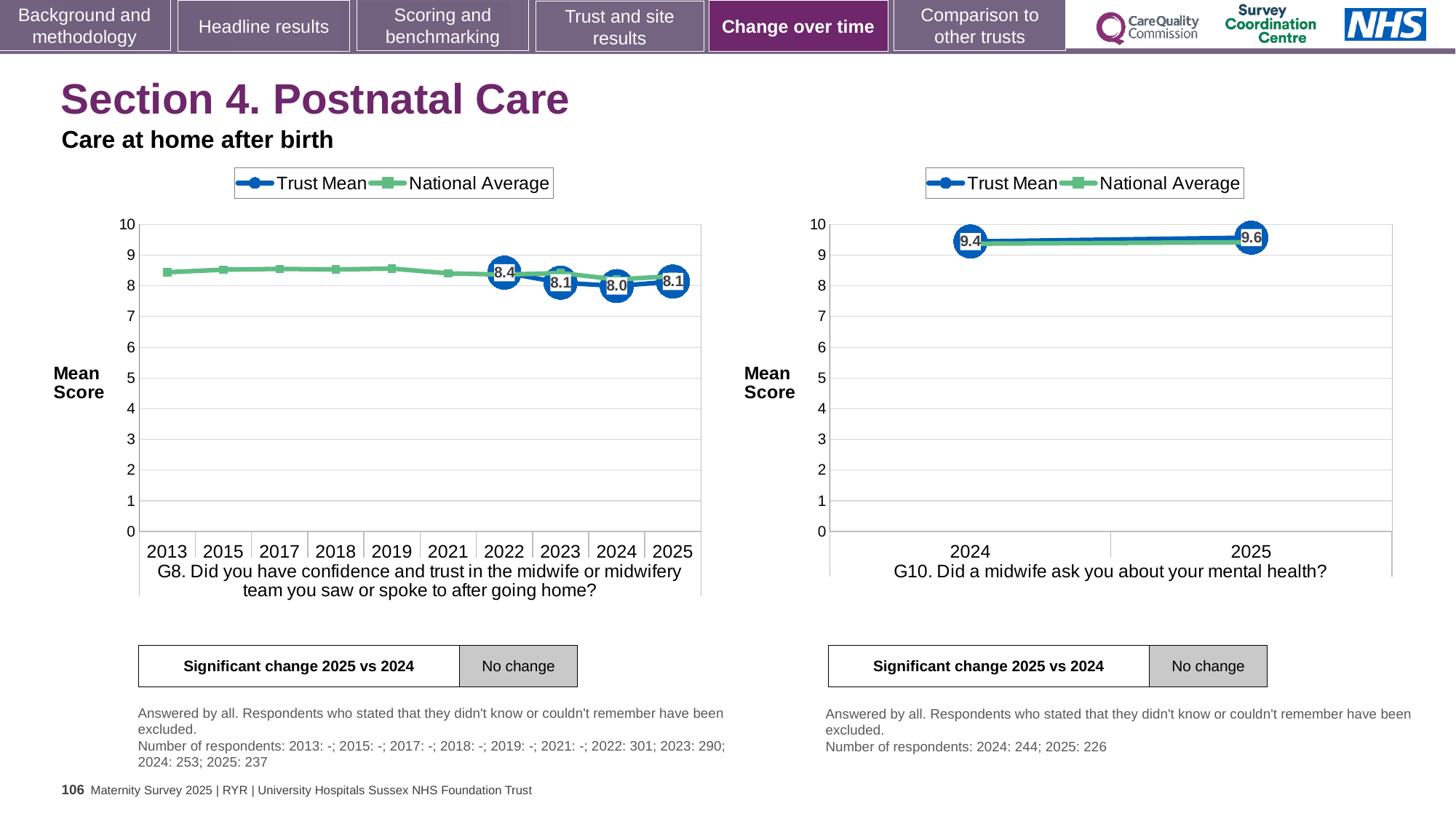
In the G8 chart, is the National Average for 2013 greater or less than 8? greater In the G8 chart, which year has the lowest labelled Trust Mean? 2024 In the G8 chart, what is the difference between the Trust Mean in 2022 and in 2024? 0.4 In the G10 chart, what is the difference between the Trust Mean in 2025 and in 2024? 0.2 In the G8 chart, what is the Trust Mean for 2025? 8.1 In the G8 chart, which year has the highest labelled Trust Mean? 2022 In the G10 chart, does the Trust Mean rise or fall from 2024 to 2025? rise In the G8 chart, what is the Trust Mean for 2022? 8.4 In the G8 chart, what is the Trust Mean for 2024? 8.0 How many series does the legend of the G10 chart list? 2 In the G10 chart, what is the Trust Mean for 2025? 9.6 In the G8 chart, how many years are shown on the x axis? 10